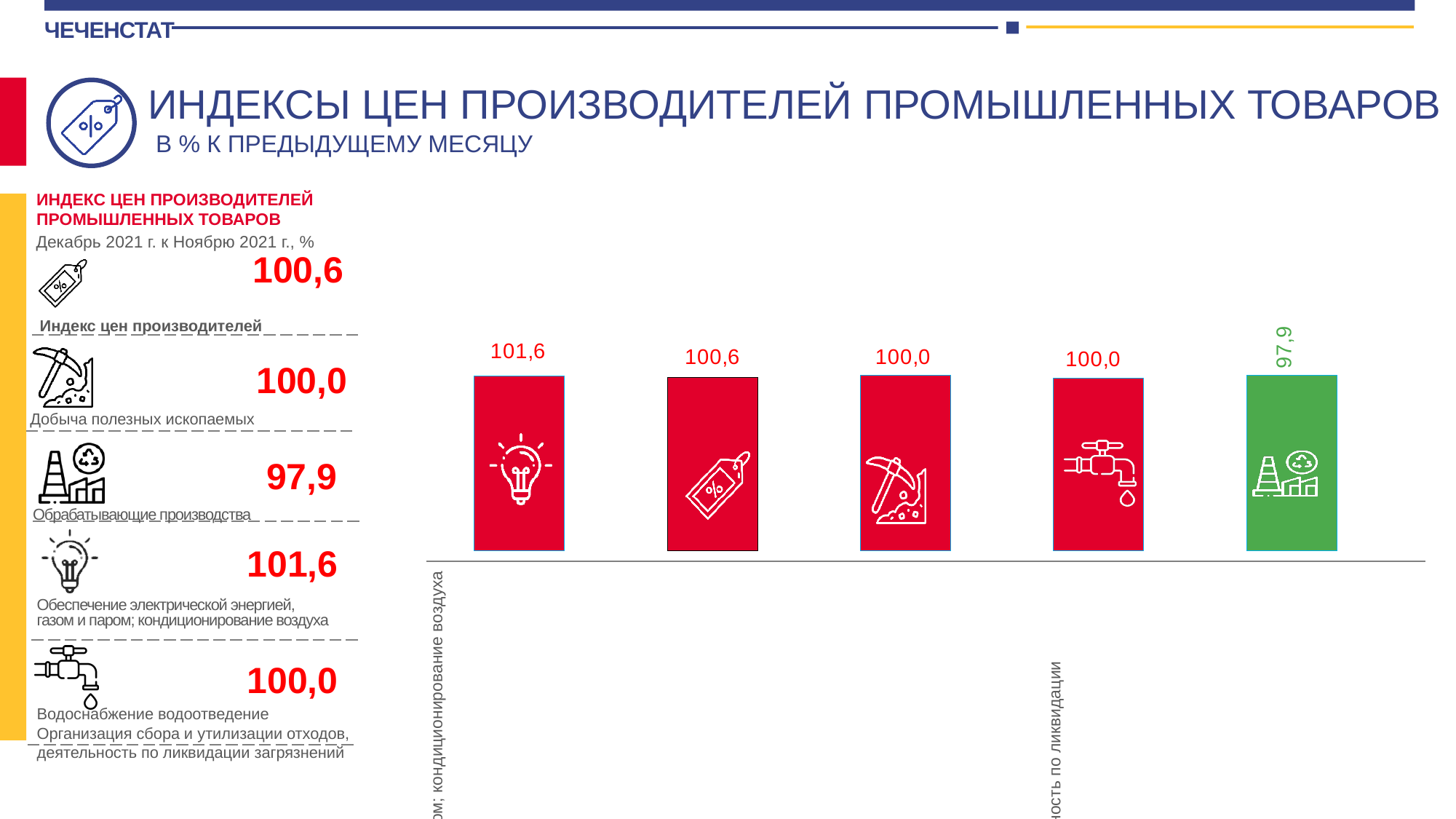
Which bar has the lowest value in the chart? the last (rightmost) bar, 97,9 Do the bar values generally rise or fall from left to right across the chart? fall Which is larger: the value of the first bar or the value of the second bar? the first bar (101,6) What is the value labelled on the second bar from the left in the chart? 100,6 What is the value labelled on the first (leftmost) bar of the chart? 101,6 What type of chart is shown on the slide? bar chart How many bars are plotted in the chart? 5 What is the value labelled on the bar with the water tap icon? 100,0 What is the difference between the first bar (101,6) and the last bar (97,9)? 3,7 Which bar has the highest value in the chart? the first (leftmost) bar, 101,6 What colour is the bar with the lowest value (97,9)? green What is the value labelled on the last (rightmost) bar of the chart? 97,9